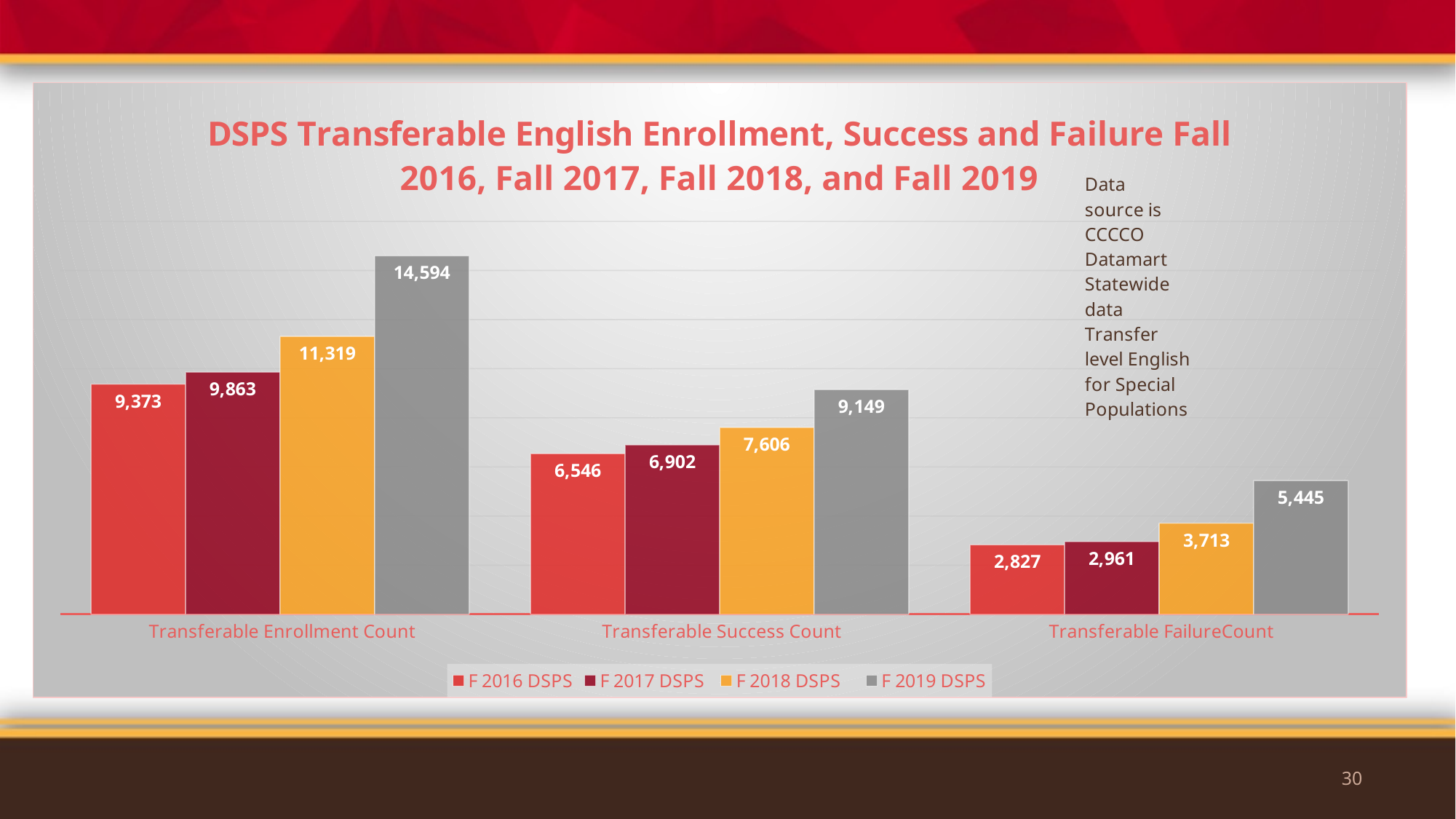
What kind of chart is shown on the slide? Bar chart What is the Transferable FailureCount for F 2018 DSPS? 3,713 Which is larger: the F 2018 DSPS Transferable Success Count or the F 2019 DSPS Transferable FailureCount? F 2018 DSPS Transferable Success Count Do the Transferable FailureCount values rise or fall from F 2016 DSPS to F 2019 DSPS? Rise What is the Transferable Success Count for F 2017 DSPS? 6,902 Which series has the lowest Transferable FailureCount? F 2016 DSPS How many categories are shown on the x axis? 3 How many series does the legend list? 4 Which series has the highest Transferable Enrollment Count? F 2019 DSPS What is the difference between the F 2017 DSPS and F 2016 DSPS Transferable Success Count? 356 What is the Transferable Enrollment Count for F 2019 DSPS? 14,594 What is the difference between the F 2019 DSPS and F 2018 DSPS Transferable Enrollment Count? 3,275